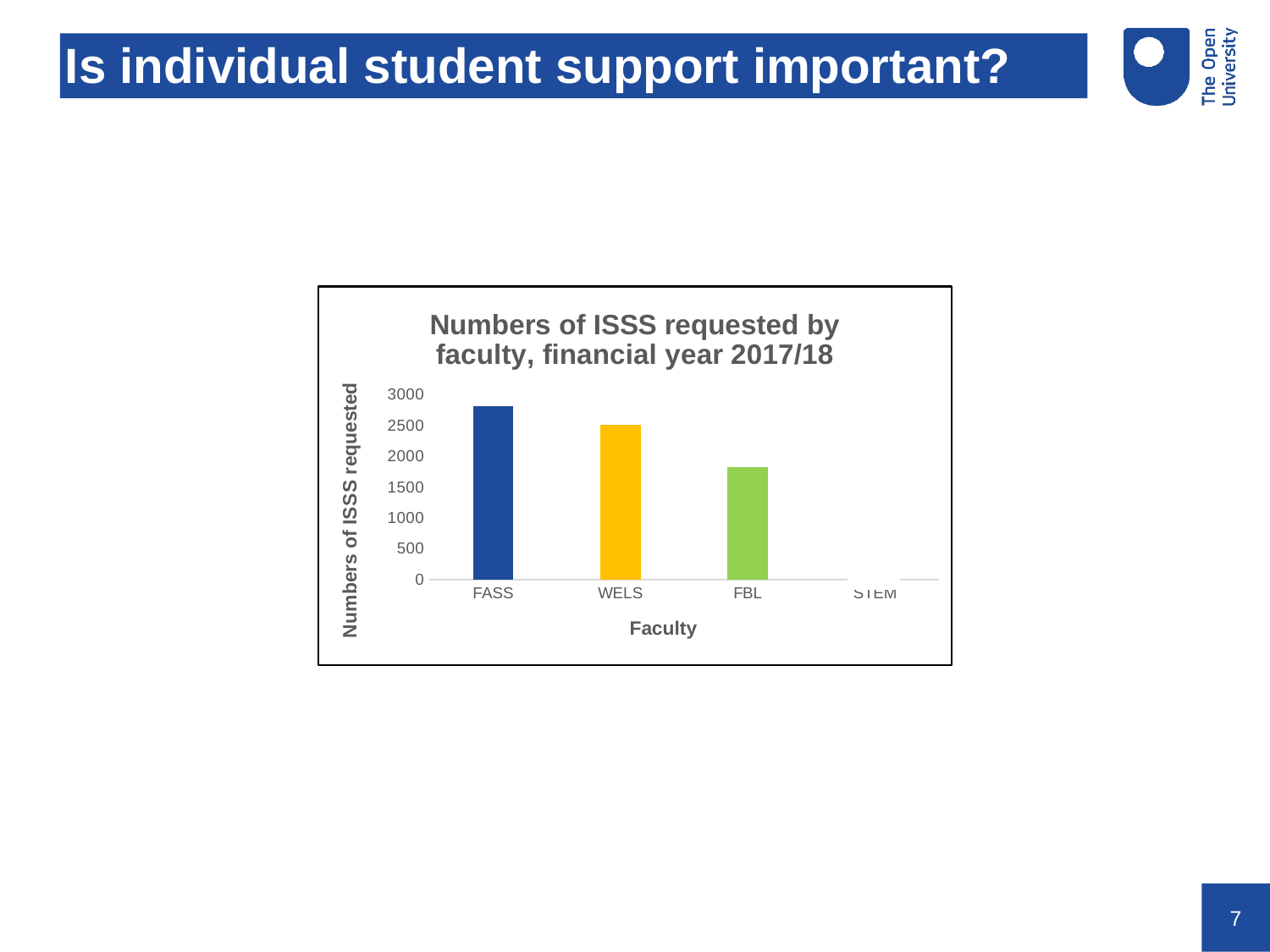
Do the bar values rise or fall from left to right across FASS, WELS and FBL? Fall Is the value for FBL greater or less than 2000? less Is the value for FASS greater or less than 2500? greater Of FASS, WELS and FBL, which faculty has the lowest bar? FBL What is the title of the chart? Numbers of ISSS requested by faculty, financial year 2017/18 Is the value for WELS greater or less than 2000? greater Which is larger, the value for WELS or the value for FBL? WELS Which faculty has the highest number of ISSS requested? FASS What kind of chart is shown on the slide? Bar chart How many faculties are listed on the x axis? 4 What is the label on the y axis? Numbers of ISSS requested